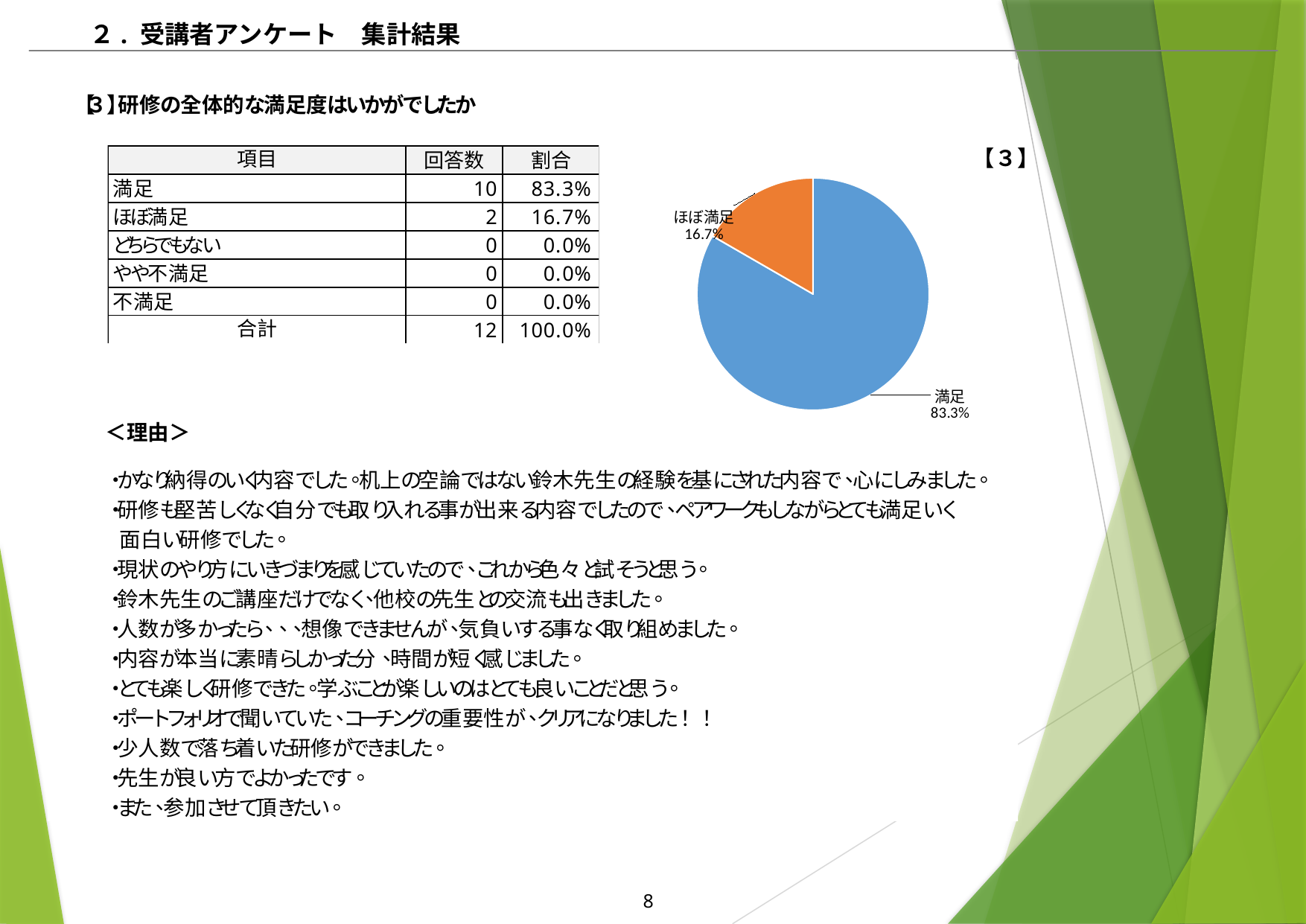
What share of the pie chart does 満足 represent? 83.3% What is the difference in percentage points between the 満足 slice and the ほぼ満足 slice? 66.6 How many slices are shown in the pie chart? 2 What share of the pie chart does ほぼ満足 represent? 16.7% What colour is the ほぼ満足 slice in the pie chart? orange Which is larger in the pie chart, 満足 or ほぼ満足? 満足 Which slice of the pie chart is the largest? 満足 Is the share for 満足 in the pie chart greater or less than 50%? greater What colour is the 満足 slice in the pie chart? blue Which slice of the pie chart is the smallest? ほぼ満足 What kind of chart is shown on the slide? pie chart